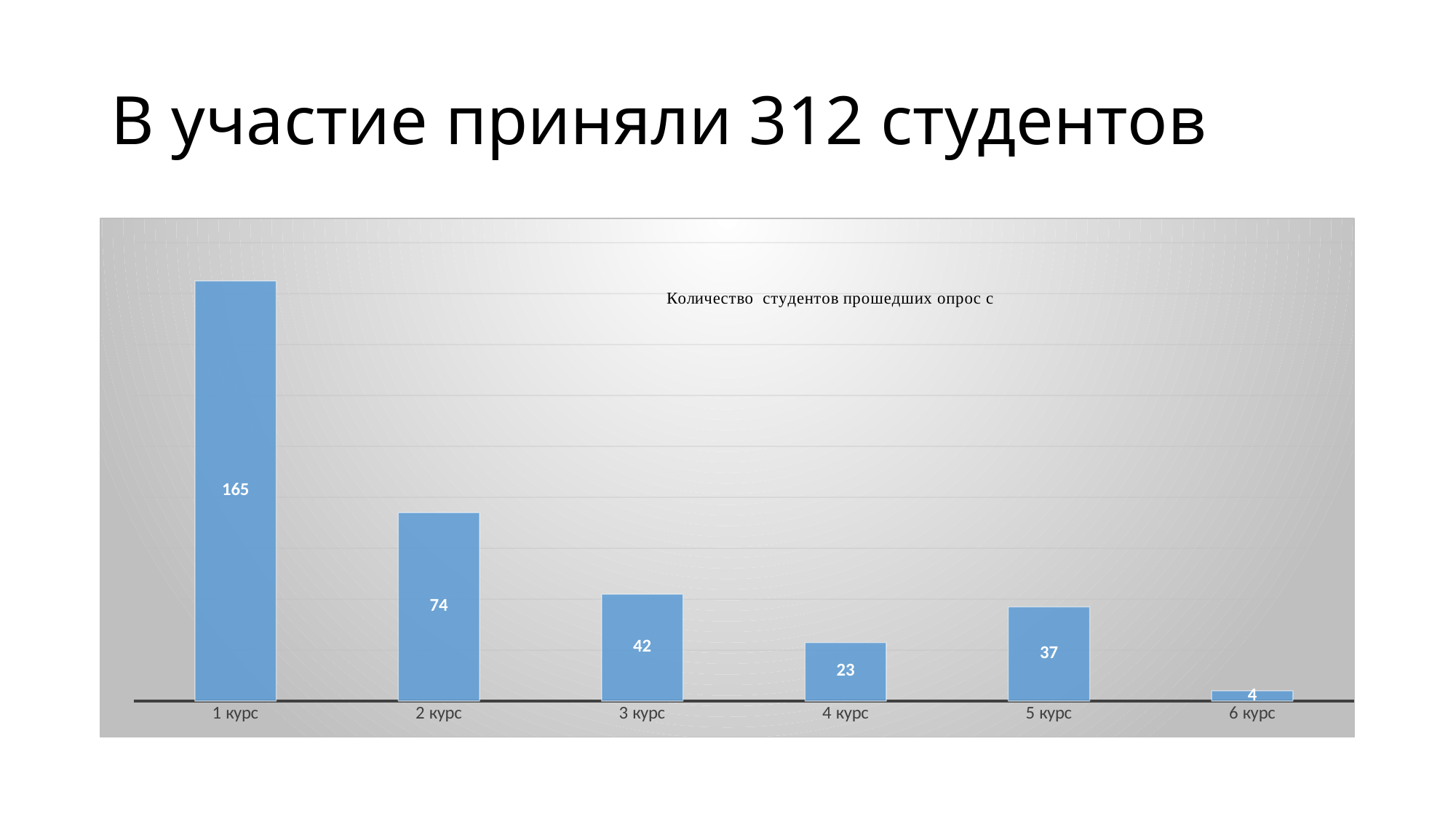
What is the difference between the values for 1 курс and 2 курс? 91 What is the value for 2 курс? 74 How many categories are shown on the x axis? 6 Which category has the lowest value? 6 курс What is the difference between the values for 3 курс and 5 курс? 5 What is the title of the chart? Количество студентов прошедших опрос с Which is larger, the value for 3 курс or the value for 4 курс? 3 курс What is the value for 1 курс? 165 Which category has the highest value? 1 курс What is the value for 6 курс? 4 What is the value for 4 курс? 23 What kind of chart is shown on the slide? bar chart